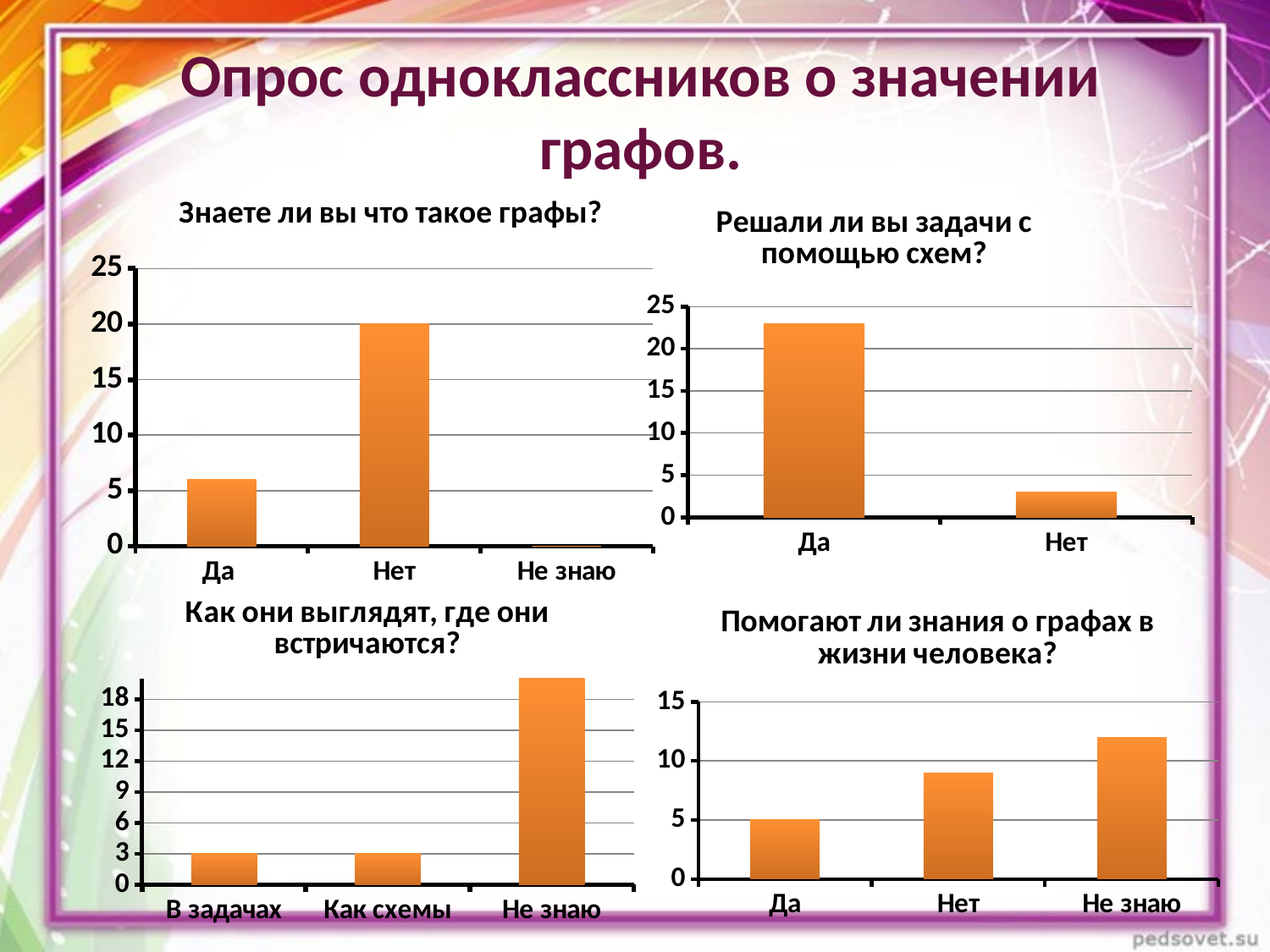
How many categories are shown in the chart 'Решали ли вы задачи с помощью схем?'? 2 In the chart 'Решали ли вы задачи с помощью схем?', is the value for 'Да' greater or less than 20? greater In the chart 'Знаете ли вы что такое графы?', which category has the highest value? Нет In the chart 'Решали ли вы задачи с помощью схем?', which category has the highest value? Да How many categories are shown in the chart 'Помогают ли знания о графах в жизни человека?'? 3 In the chart 'Знаете ли вы что такое графы?', is the value for 'Да' greater or less than 10? less In the chart 'Помогают ли знания о графах в жизни человека?', what is the value for 'Да'? 5 In the chart 'Как они выглядят, где они встричаются?', what is the value for 'В задачах'? 3 What type of chart is 'Как они выглядят, где они встричаются?'? bar chart In the chart 'Знаете ли вы что такое графы?', what is the value for 'Нет'? 20 In the chart 'Помогают ли знания о графах в жизни человека?', which category has the lowest value? Да In the chart 'Помогают ли знания о графах в жизни человека?', which is larger, 'Нет' or 'Не знаю'? Не знаю